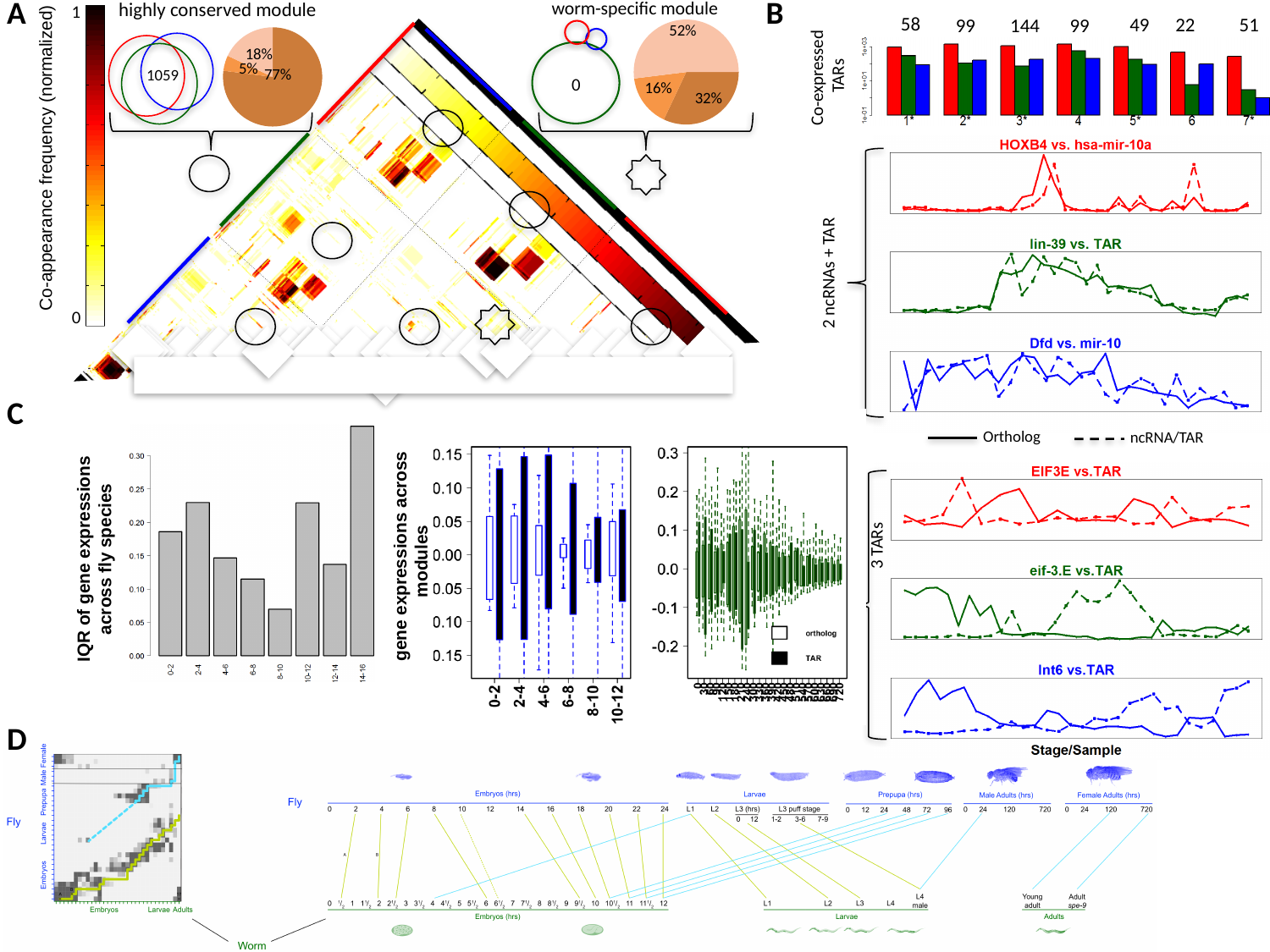
In the 'IQR of gene expressions across fly species' chart in panel C, is the value for 14-16 greater or less than 0.30? greater In the 'IQR of gene expressions across fly species' chart in panel C, which category has the lowest bar? 8-10 In the 'IQR of gene expressions across fly species' chart in panel C, which category has the highest bar? 14-16 In the 'Co-expressed TARs' bar chart in panel B, which group has the highest number printed above it? 3* In the line charts of panel B, what does the solid line represent according to the legend? Ortholog In the 'worm-specific module' pie chart in panel A, what is the share of the smallest slice? 16% In the 'highly conserved module' pie chart in panel A, what share does the largest slice have? 77% In the 'Co-expressed TARs' bar chart in panel B, which group has the lowest number printed above it? 6 In the 'worm-specific module' pie chart in panel A, what share does the largest slice have? 52% In the 'Co-expressed TARs' bar chart in panel B, what number is printed above group 3*? 144 In the 'IQR of gene expressions across fly species' chart in panel C, how many bars are there? 8 In the 'Co-expressed TARs' bar chart in panel B, what is the difference between the numbers printed above group 3* and group 6? 122